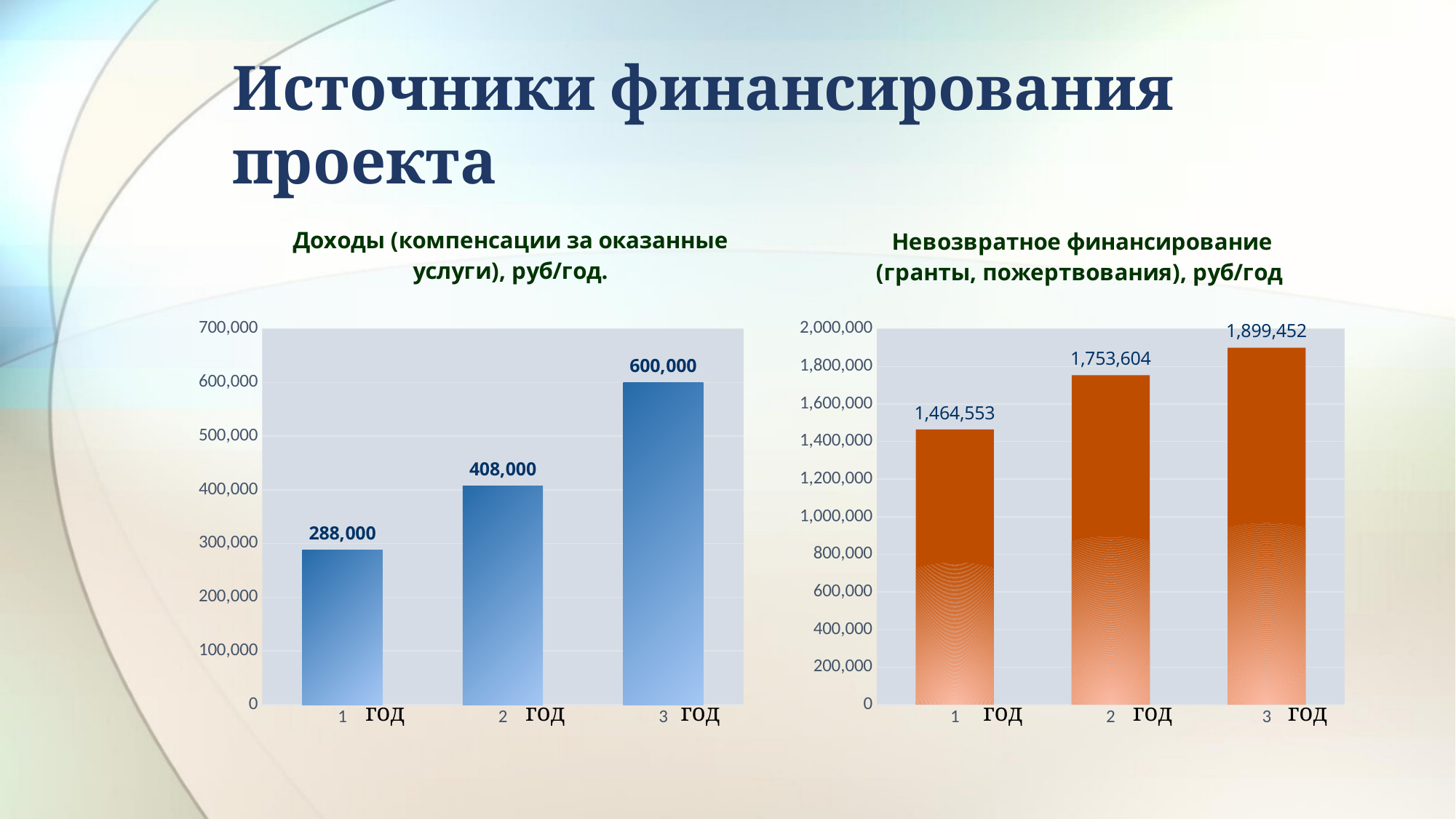
In the left chart (Доходы), is the value for year 2 larger or smaller than the value for year 3? smaller In the right chart (Невозвратное финансирование), what is the value for year 2 (2 год)? 1,753,604 In the left chart (Доходы), what is the value for year 1 (1 год)? 288,000 In the left chart (Доходы), which year has the highest value? 3 год In the left chart (Доходы), do the values rise or fall from year 1 to year 3? rise How many bars does the right chart (Невозвратное финансирование) have? 3 In the right chart (Невозвратное финансирование), what is the value for year 3 (3 год)? 1,899,452 In the right chart (Невозвратное финансирование), which year has the lowest value? 1 год In the left chart (Доходы), what is the value for year 3 (3 год)? 600,000 In the right chart (Невозвратное финансирование), what is the difference between the values for year 3 and year 1? 434,899 What type of chart is the left chart (Доходы)? bar chart In the left chart (Доходы), what is the difference between the values for year 3 and year 1? 312,000